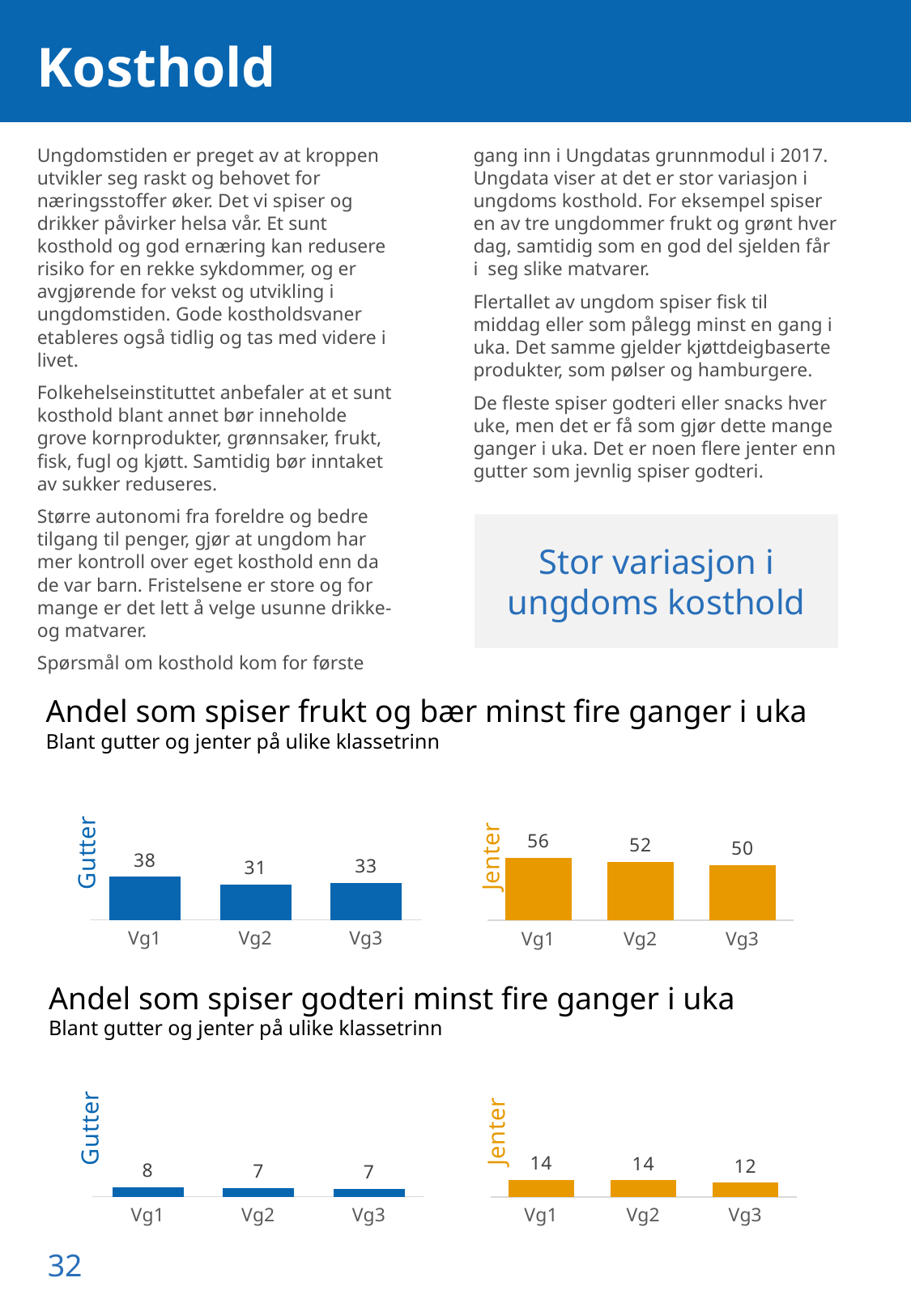
What type of chart is used in 'Andel som spiser frukt og bær minst fire ganger i uka'? bar chart In the chart 'Andel som spiser godteri minst fire ganger i uka', what is the difference between Jenter at Vg1 and Gutter at Vg1? 6 In the chart 'Andel som spiser frukt og bær minst fire ganger i uka', which class level has the lowest value for Gutter? Vg2 In the chart 'Andel som spiser godteri minst fire ganger i uka', which is larger at Vg2: Gutter or Jenter? Jenter In the chart 'Andel som spiser frukt og bær minst fire ganger i uka', what is the value for Gutter at Vg1? 38 In the chart 'Andel som spiser godteri minst fire ganger i uka', what is the value for Jenter at Vg3? 12 How many class levels are shown on the x axis of the Gutter chart in 'Andel som spiser godteri minst fire ganger i uka'? 3 In the chart 'Andel som spiser frukt og bær minst fire ganger i uka', what is the difference between Jenter and Gutter at Vg1? 18 In the chart 'Andel som spiser frukt og bær minst fire ganger i uka', which class level has the highest value for Jenter? Vg1 In the chart 'Andel som spiser frukt og bær minst fire ganger i uka', do the Jenter values rise or fall from Vg1 to Vg3? fall In the chart 'Andel som spiser frukt og bær minst fire ganger i uka', what is the value for Jenter at Vg3? 50 In the chart 'Andel som spiser godteri minst fire ganger i uka', what is the value for Gutter at Vg1? 8